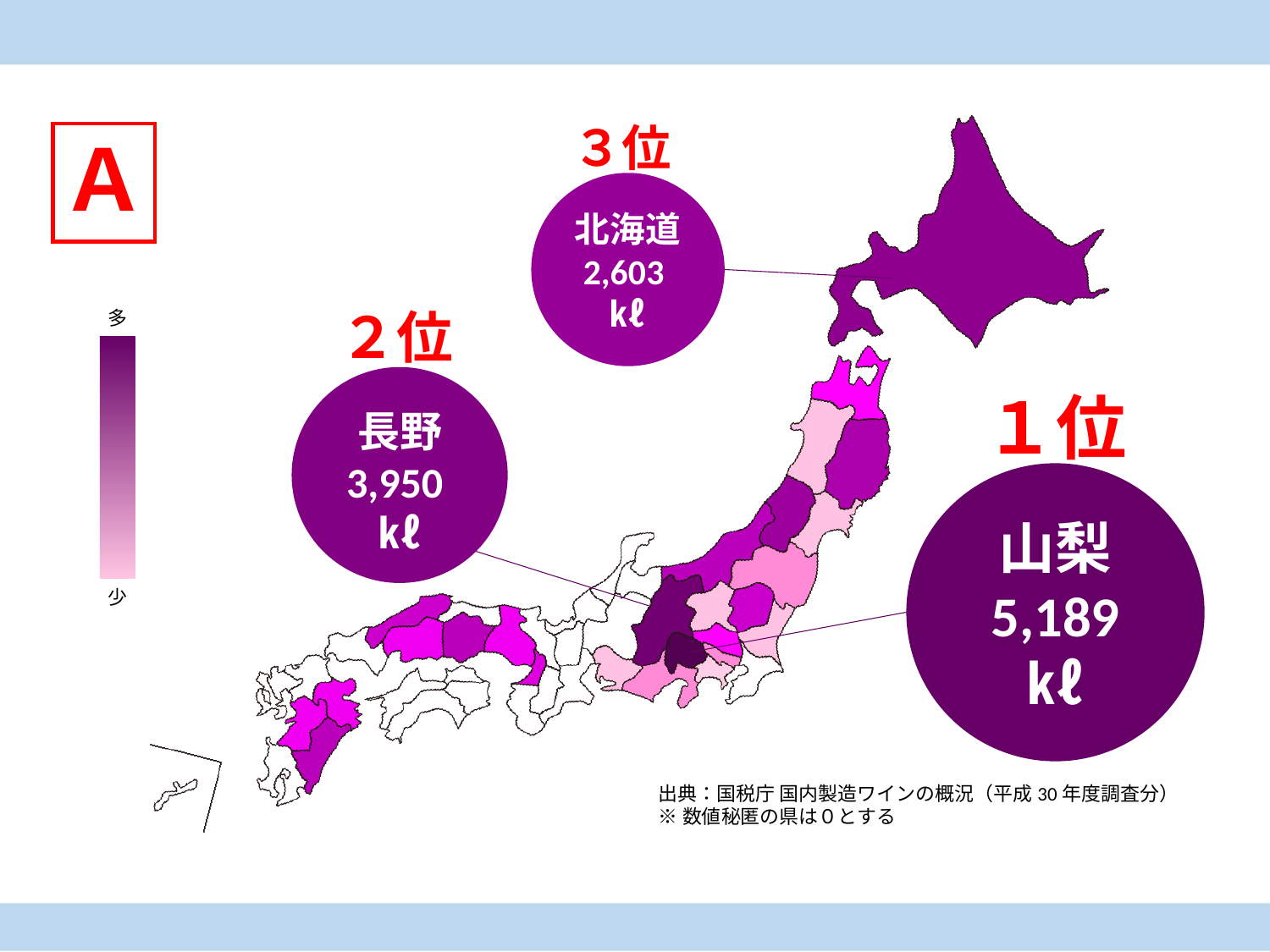
What value is shown for 長野 on the map? 3,950 kℓ What is the difference between the values for 山梨 and 長野? 1,239 kℓ What value is shown for 山梨 on the map? 5,189 kℓ How many prefectures are called out with a rank and value on the map? 3 What kind of chart is shown on the slide? Map (choropleth map of Japan) What is the difference between the values for 長野 and 北海道? 1,347 kℓ Which prefecture is ranked 3位 on the map? 北海道 Which has a larger value, 北海道 or 長野? 長野 Among the three labelled prefectures, which has the lowest value? 北海道 What value is shown for 北海道 on the map? 2,603 kℓ Which prefecture is ranked 2位 on the map? 長野 Which prefecture is ranked 1位 on the map? 山梨